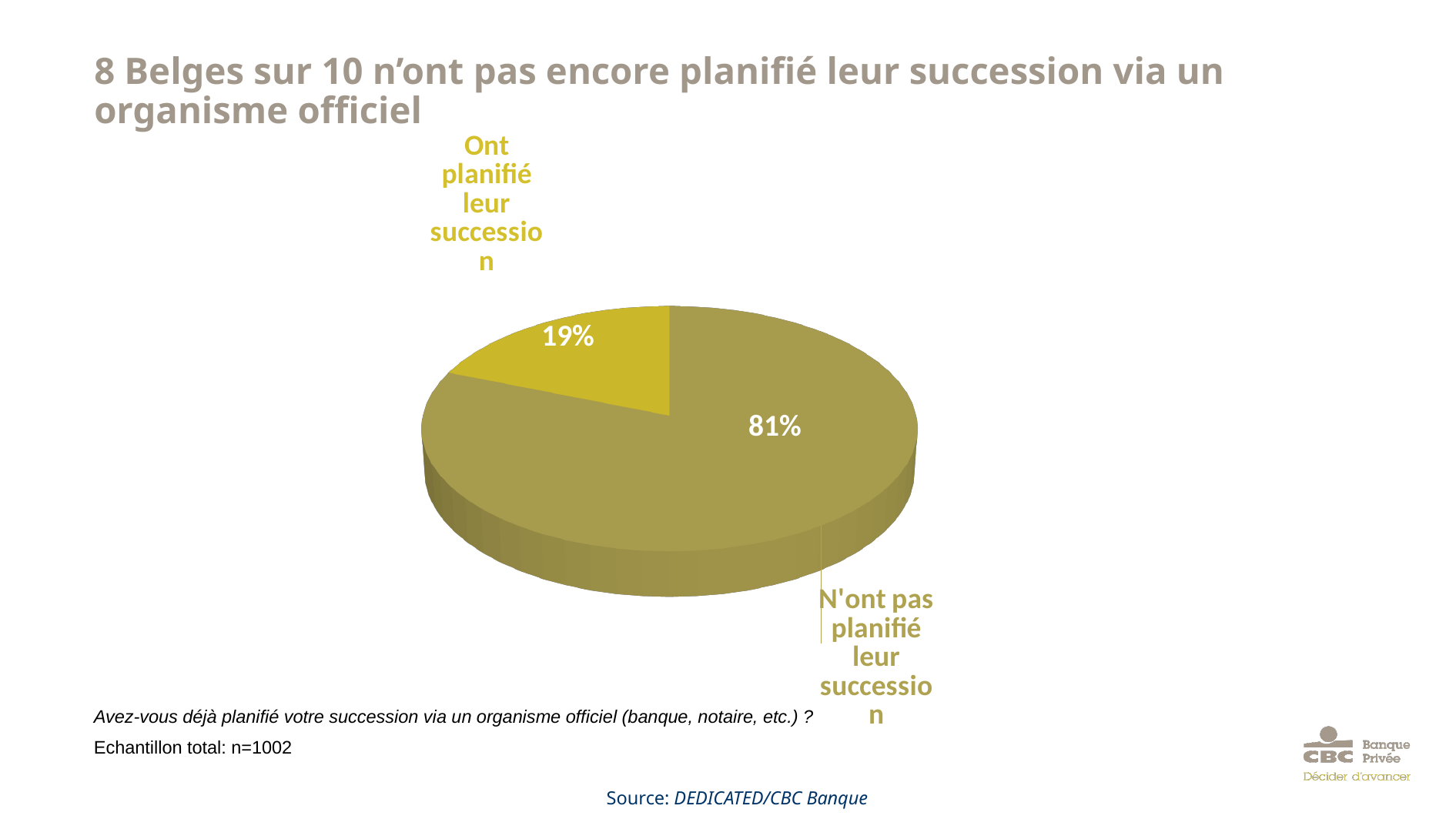
What type of chart is shown on the slide? Pie chart What is the source cited for the chart data? DEDICATED/CBC Banque What percentage of respondents have planned their succession ("Ont planifié leur succession")? 19% What share of the pie does the "Ont planifié leur succession" slice represent? 19% Which category has the largest share of the pie? N'ont pas planifié leur succession What is the total sample size stated on the slide? n=1002 Which category has the smallest share of the pie? Ont planifié leur succession What is the difference in percentage points between the "N'ont pas planifié leur succession" slice and the "Ont planifié leur succession" slice? 62 How many slices does the pie chart have? 2 Which is larger: the share of respondents who have planned their succession or the share who have not? N'ont pas planifié leur succession What percentage of respondents have not planned their succession ("N'ont pas planifié leur succession")? 81%